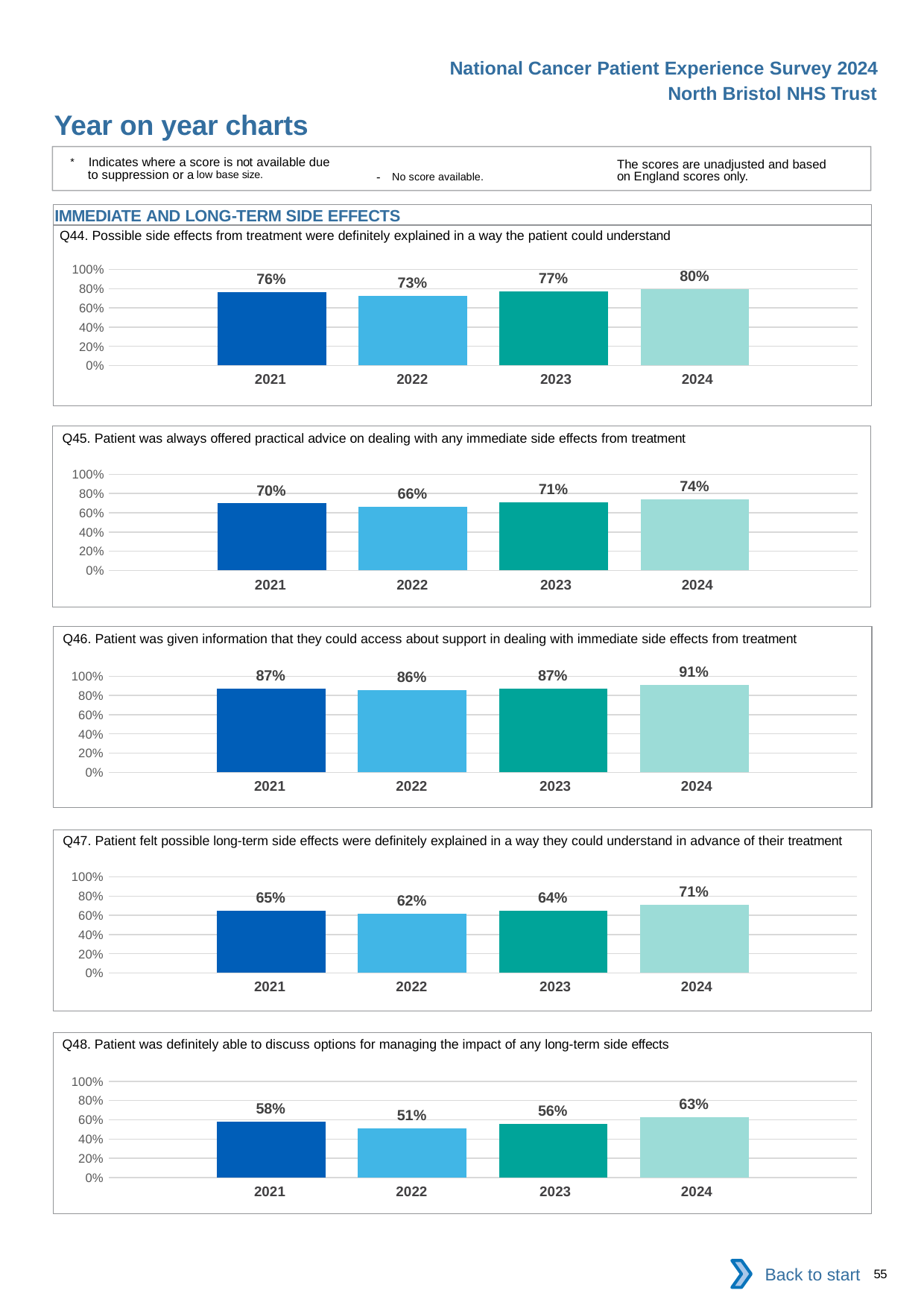
In the Q45 chart, is the value for 2024 greater or less than 60%? greater How many years are shown in the Q44 chart? 4 In the Q46 chart, what is the value for 2023? 87% In the Q48 chart, what is the value for 2022? 51% In the Q45 chart, which year has the lowest value? 2022 In the Q44 chart, what is the value for 2024? 80% In the Q48 chart, which year has the highest value? 2024 In the Q47 chart, which is larger, the value for 2021 or the value for 2023? 2021 In the Q46 chart, what is the difference between the 2024 and 2022 values? 5% What kind of chart is the Q45 chart? bar chart How many charts are shown on the slide? 5 In the Q47 chart, what is the difference between the 2024 and 2021 values? 6%